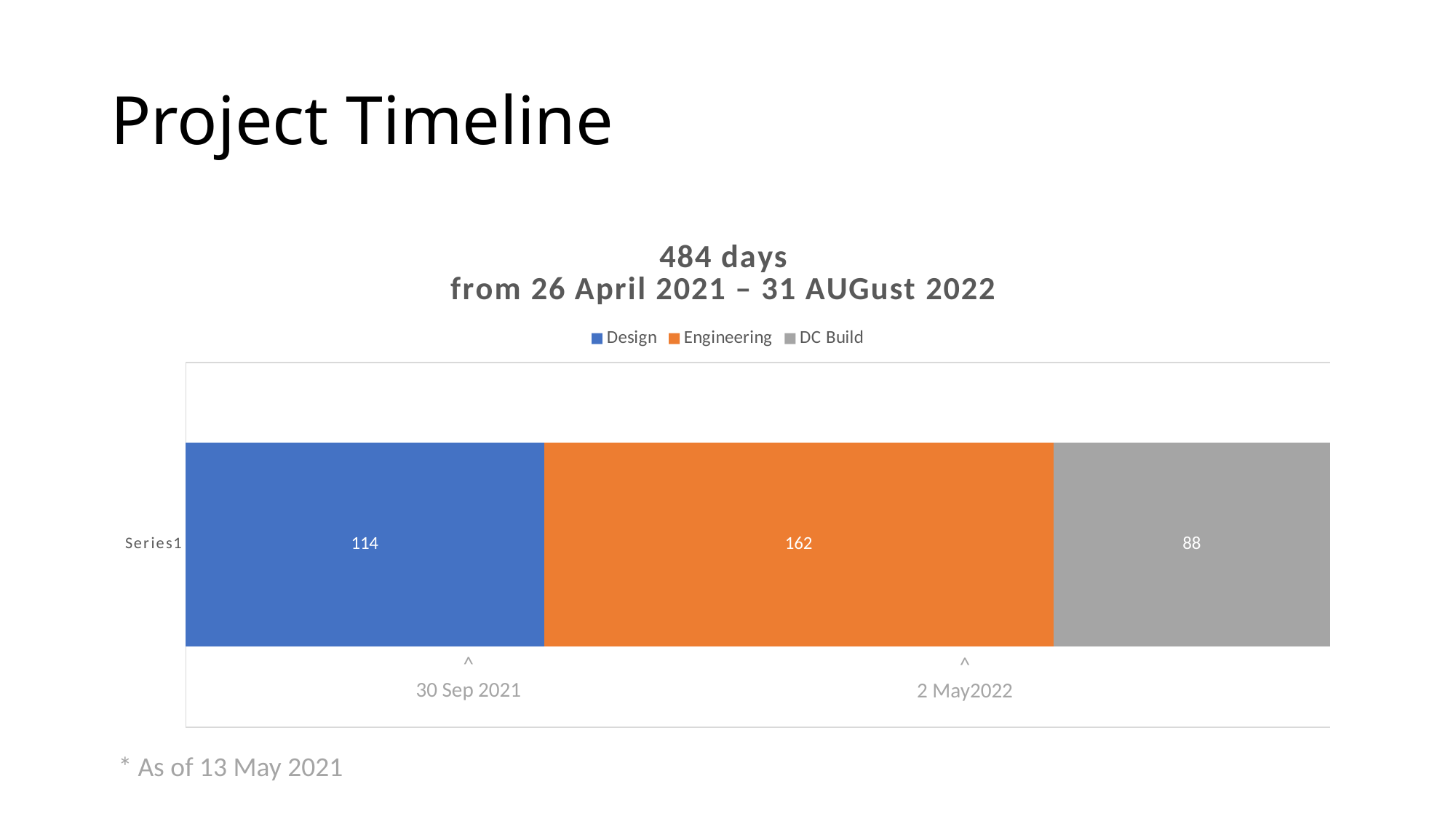
What colour is the Engineering segment? Orange What kind of chart is shown on the slide? Stacked bar chart What is the difference between the Design and DC Build values? 26 What is the difference between the Engineering and Design values? 48 Which series has the largest segment in the bar? Engineering Which series has the smallest segment in the bar? DC Build What is the value of the DC Build segment? 88 How many series does the legend list? 3 What is the value of the Engineering segment? 162 What is the value of the Design segment? 114 Which is larger, the Design segment or the DC Build segment? Design What is the total of the three segments in the stacked bar? 364